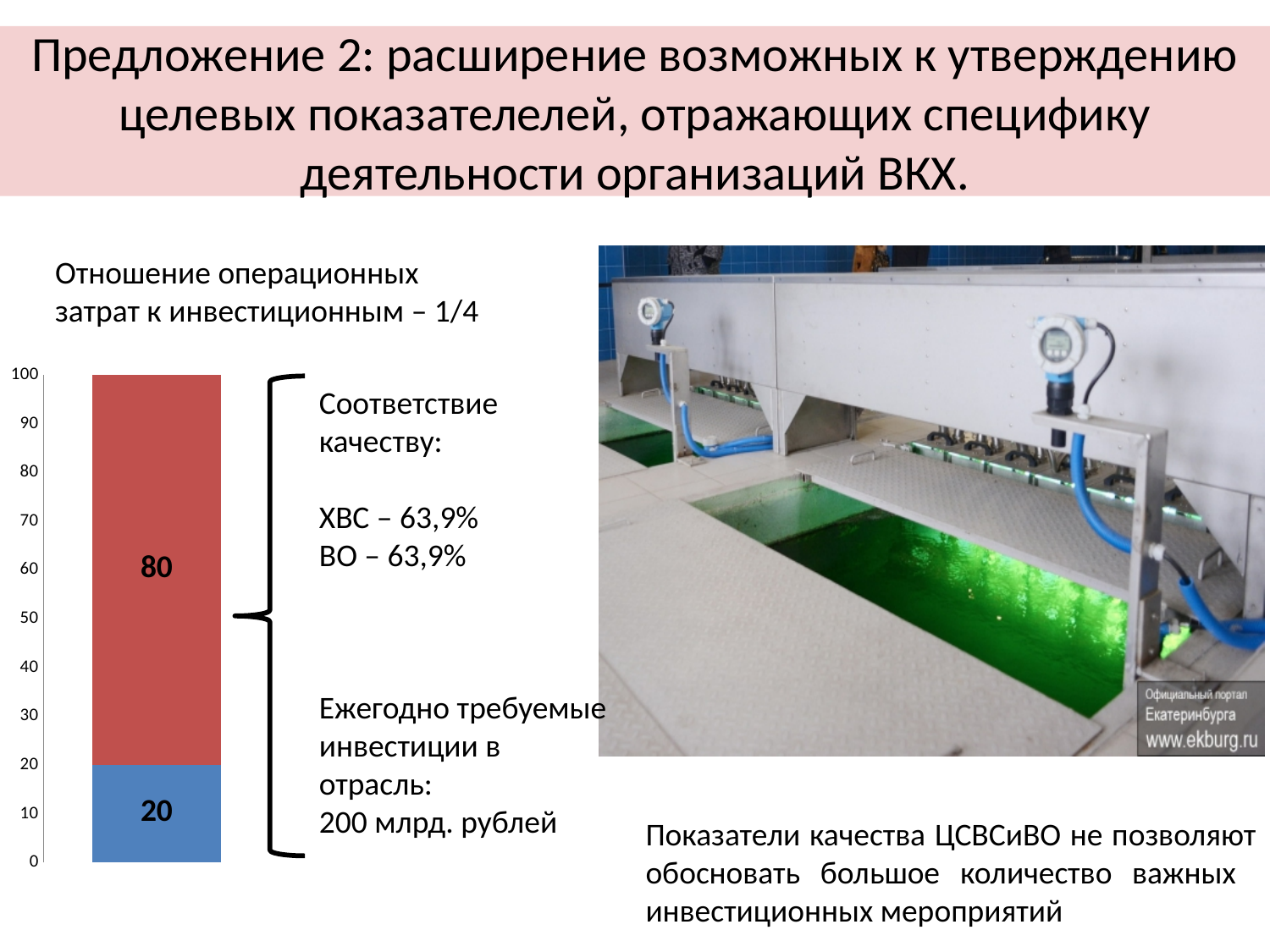
What kind of chart is shown on the left of the slide? stacked bar chart What is the total of the stacked bar? 100 Which segment of the bar has the largest value? the red segment (80) What is the maximum value shown on the vertical axis? 100 How many segments does the stacked bar contain? 2 Which segment of the bar has the smallest value? the blue segment (20) What is the difference between the red segment value and the blue segment value? 60 What value is printed on the red (upper) segment of the bar? 80 What colour is the bottom segment of the bar? blue Which segment is larger, the red one or the blue one? red What value is printed on the blue (lower) segment of the bar? 20 Is the value of the blue segment greater or less than 50? less